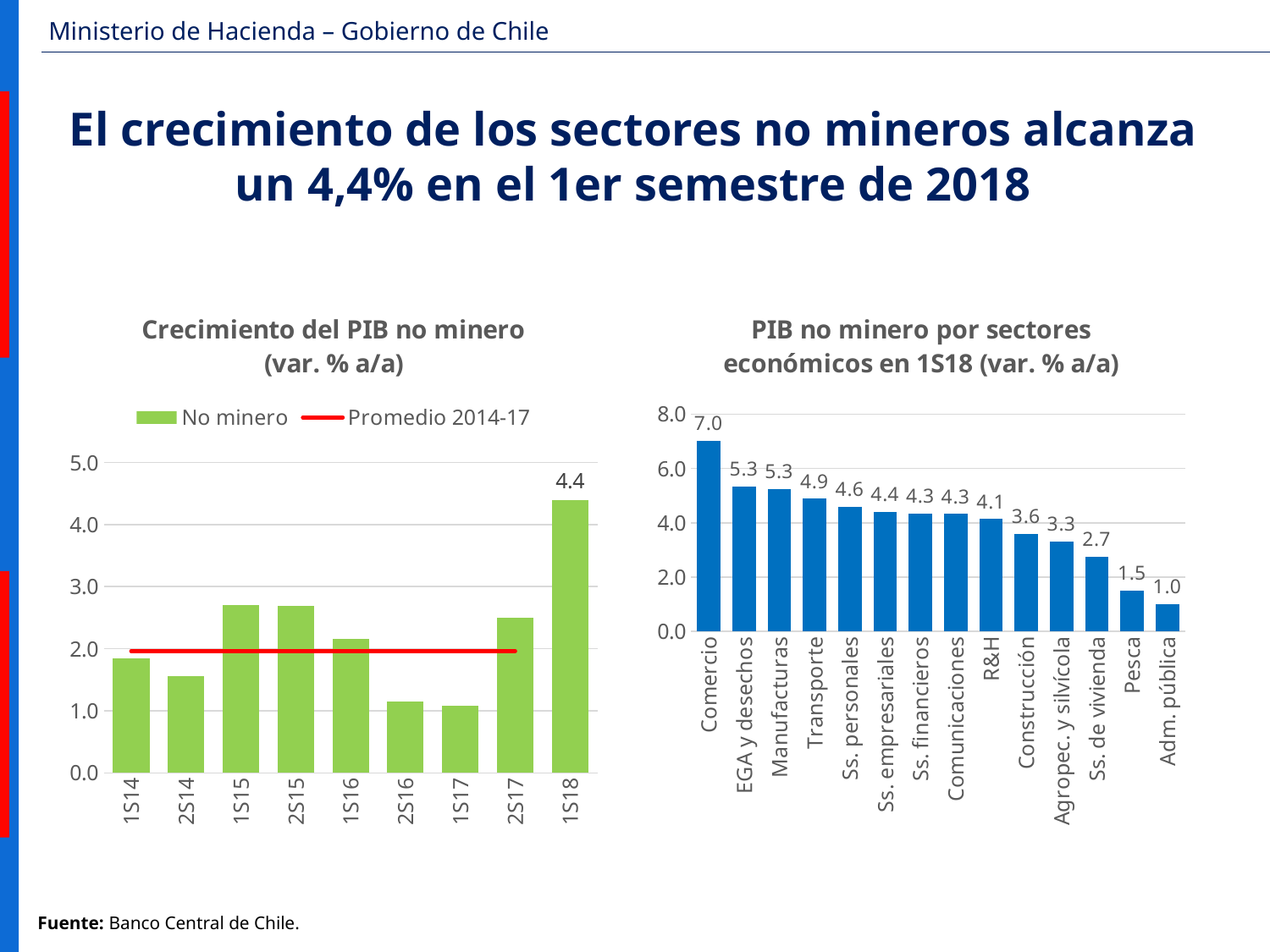
In the chart 'PIB no minero por sectores económicos en 1S18', how many sectors are shown? 14 In the chart 'Crecimiento del PIB no minero', how many series does the legend list? 2 In the chart 'PIB no minero por sectores económicos en 1S18', what is the difference between the values for Comercio and Pesca? 5.5 In the chart 'Crecimiento del PIB no minero', what is the value for 1S18? 4.4 In the chart 'PIB no minero por sectores económicos en 1S18', what is the value for Comercio? 7.0 What type of chart is 'PIB no minero por sectores económicos en 1S18'? bar chart In the chart 'Crecimiento del PIB no minero', is the value for 2S16 greater or less than 2.0? less In the chart 'PIB no minero por sectores económicos en 1S18', which is larger, the value for Transporte or the value for Agropec. y silvícola? Transporte In the chart 'PIB no minero por sectores económicos en 1S18', which sector has the lowest value? Adm. pública In the chart 'PIB no minero por sectores económicos en 1S18', which sector has the highest value? Comercio In the chart 'Crecimiento del PIB no minero', which period has the highest bar? 1S18 In the chart 'PIB no minero por sectores económicos en 1S18', what is the value for Construcción? 3.6